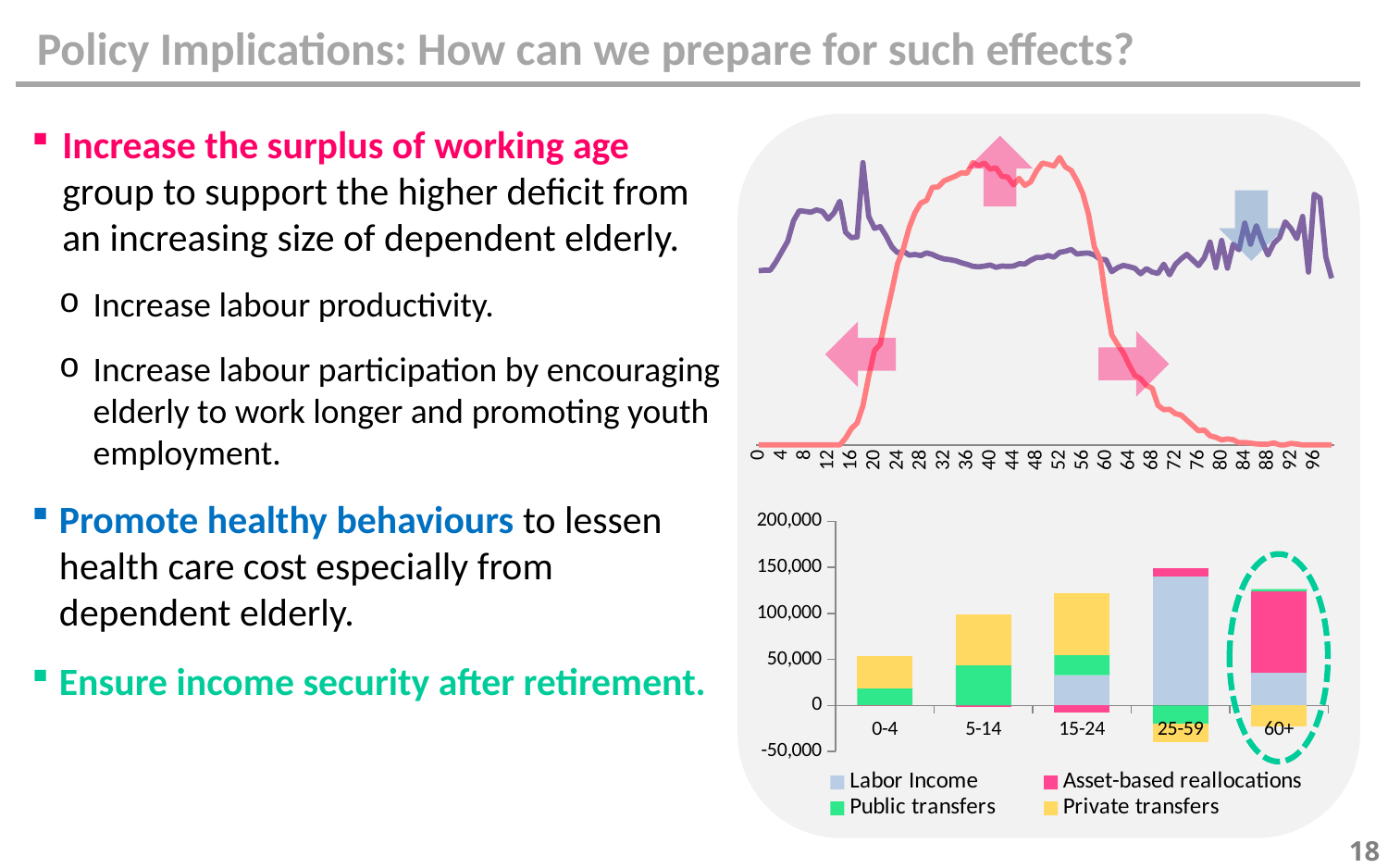
What kind of chart is the top chart on the slide? line chart In the bottom bar chart, which age group has the largest Asset-based reallocations? 60+ In the bottom bar chart, how many age-group categories are shown on the x axis? 5 In the bottom bar chart, is the Labor Income value for 60+ greater or less than 50,000? less What kind of chart is the bottom chart on the slide? bar chart In the bottom bar chart, which age group has the largest Labor Income? 25-59 In the bottom bar chart, how many series does the legend list? 4 In the bottom bar chart, is the Labor Income value for 15-24 greater or less than 50,000? less In the bottom bar chart, which is larger: the Labor Income for 25-59 or for 60+? 25-59 In the bottom bar chart, which series are listed in the legend? Labor Income, Asset-based reallocations, Public transfers, Private transfers In the bottom bar chart, is the Labor Income value for 25-59 greater or less than 100,000? greater